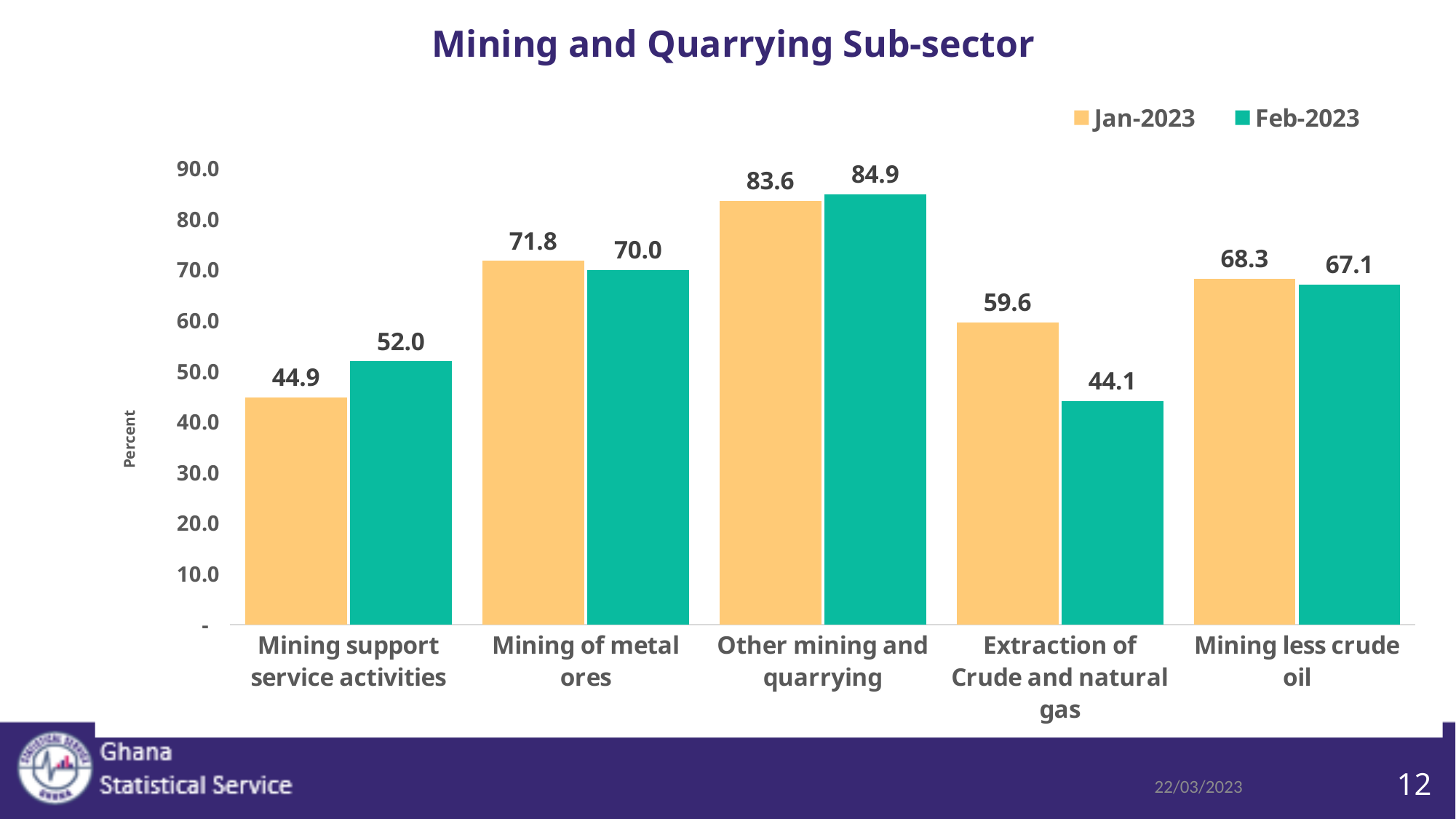
Which category has the highest Feb-2023 value? Other mining and quarrying How many categories are shown on the x axis? 5 Is the Feb-2023 value for Other mining and quarrying greater or less than 80.0? greater What is the Jan-2023 value for Mining support service activities? 44.9 Which category has the lowest Jan-2023 value? Mining support service activities How many series does the legend list? 2 What is the Feb-2023 value for Mining less crude oil? 67.1 Which is larger for Mining of metal ores: the Jan-2023 value or the Feb-2023 value? Jan-2023 What type of chart is shown on the slide? Bar chart What is the difference between the Jan-2023 and Feb-2023 values for Mining support service activities? 7.1 What is the difference between the Jan-2023 and Feb-2023 values for Extraction of Crude and natural gas? 15.5 What is the Feb-2023 value for Extraction of Crude and natural gas? 44.1